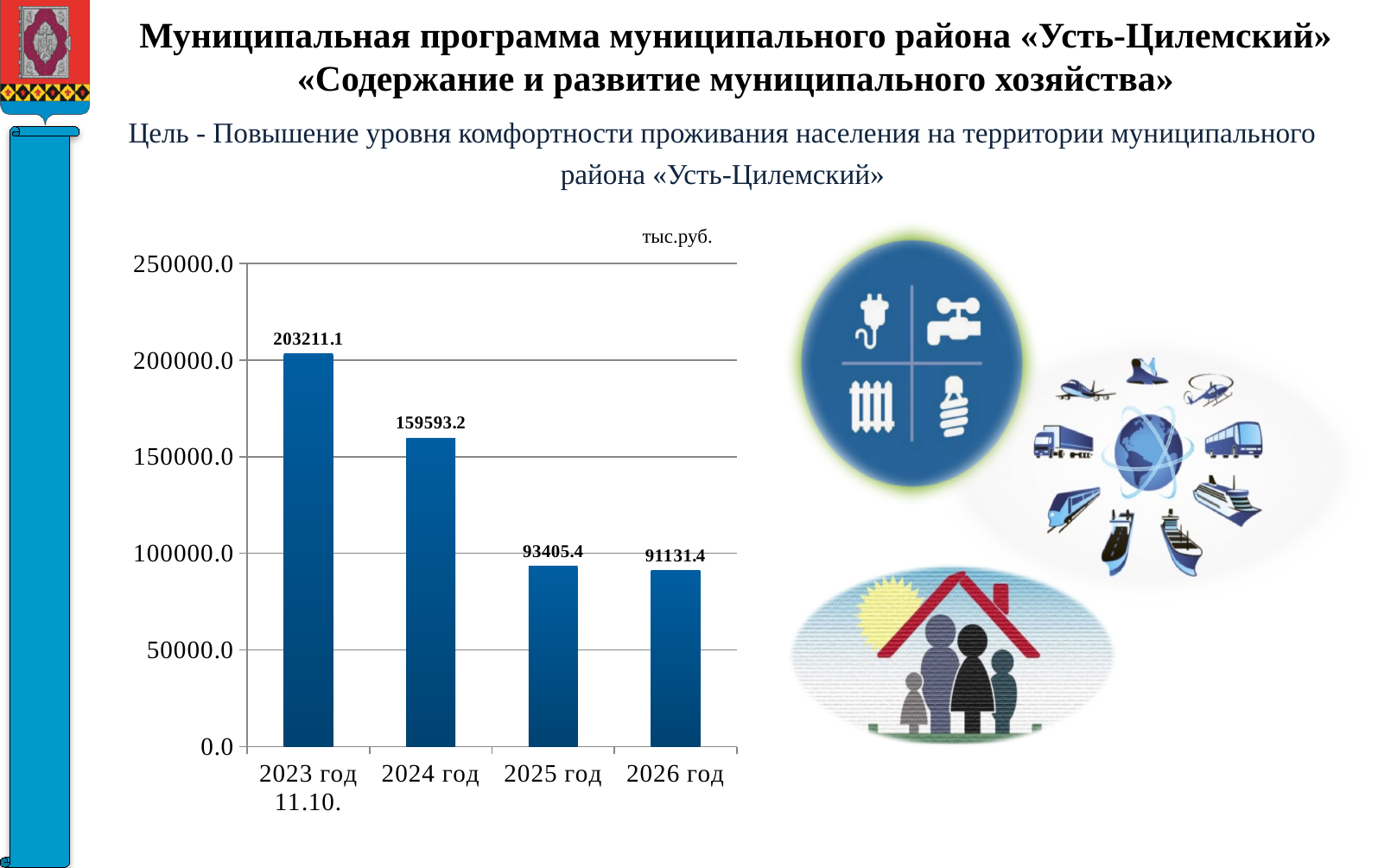
Which year has the lowest value? 2026 год What kind of chart is shown on the slide? bar chart How many years are shown on the x axis? 4 Which year has the highest value? 2023 год 11.10. What is the value shown for 2023 год 11.10.? 203211.1 What is the difference between the values for 2023 год 11.10. and 2024 год? 43617.9 Which is larger, the value for 2024 год or the value for 2025 год? 2024 год Do the values rise or fall from 2023 to 2026? fall What is the value shown for 2026 год? 91131.4 What is the difference between the values for 2025 год and 2026 год? 2274.0 Is the value for 2025 год greater or less than 100000.0? less What is the value shown for 2024 год? 159593.2